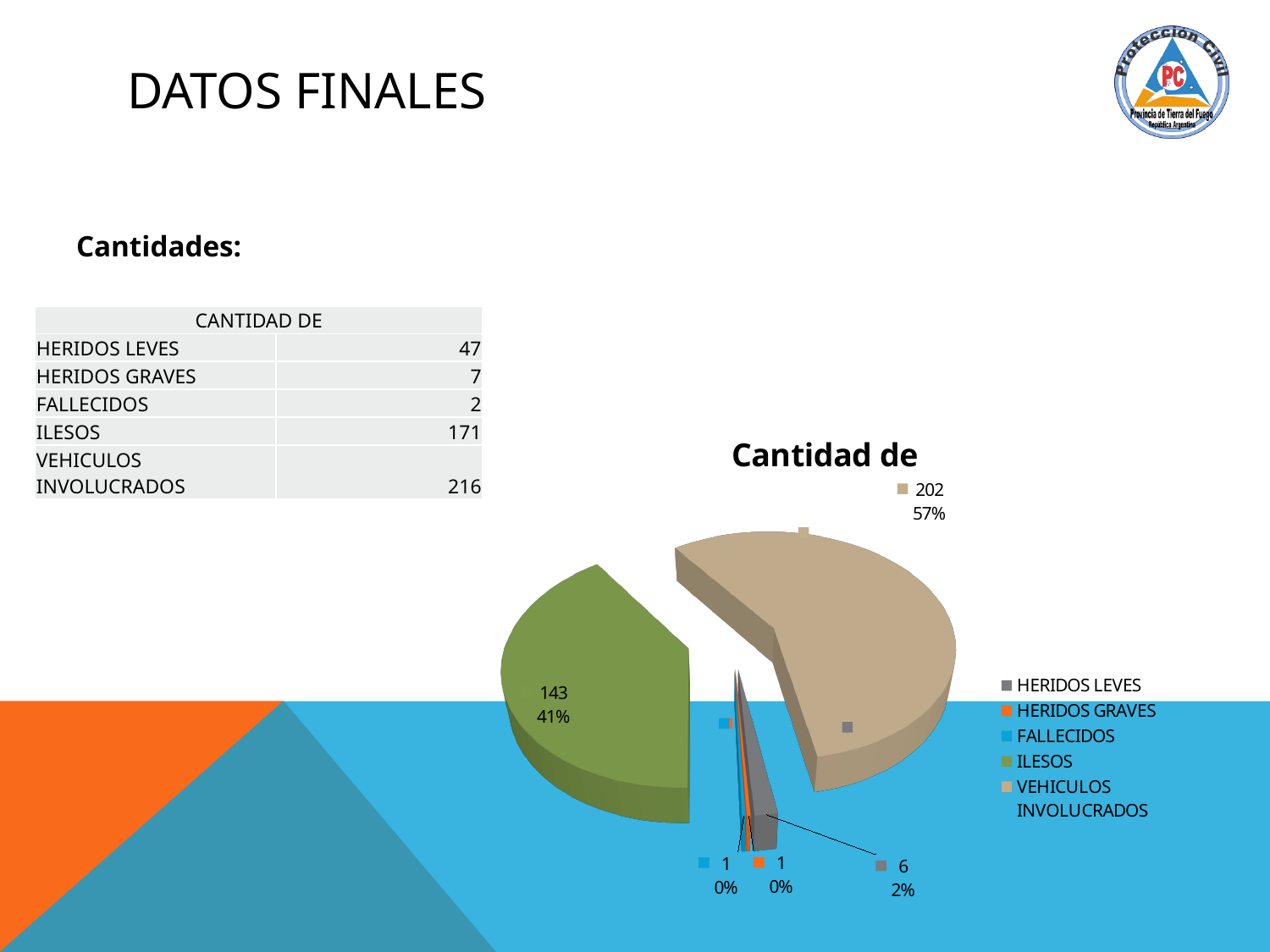
What value is shown for ILESOS in the chart? 143 What kind of chart is shown on the slide? Pie chart How many categories does the chart's legend list? 5 What percentage share is shown for the HERIDOS LEVES slice in the chart? 2% What value is shown for HERIDOS LEVES in the chart? 6 What percentage share does the VEHICULOS INVOLUCRADOS slice have in the chart? 57% What percentage share does the ILESOS slice have in the chart? 41% Which is larger in the chart, the value for ILESOS or the value for HERIDOS LEVES? ILESOS What is the title of the chart? Cantidad de What is the difference between the chart values for VEHICULOS INVOLUCRADOS and ILESOS? 59 What value is shown for VEHICULOS INVOLUCRADOS in the chart? 202 Which category has the largest slice in the chart? VEHICULOS INVOLUCRADOS